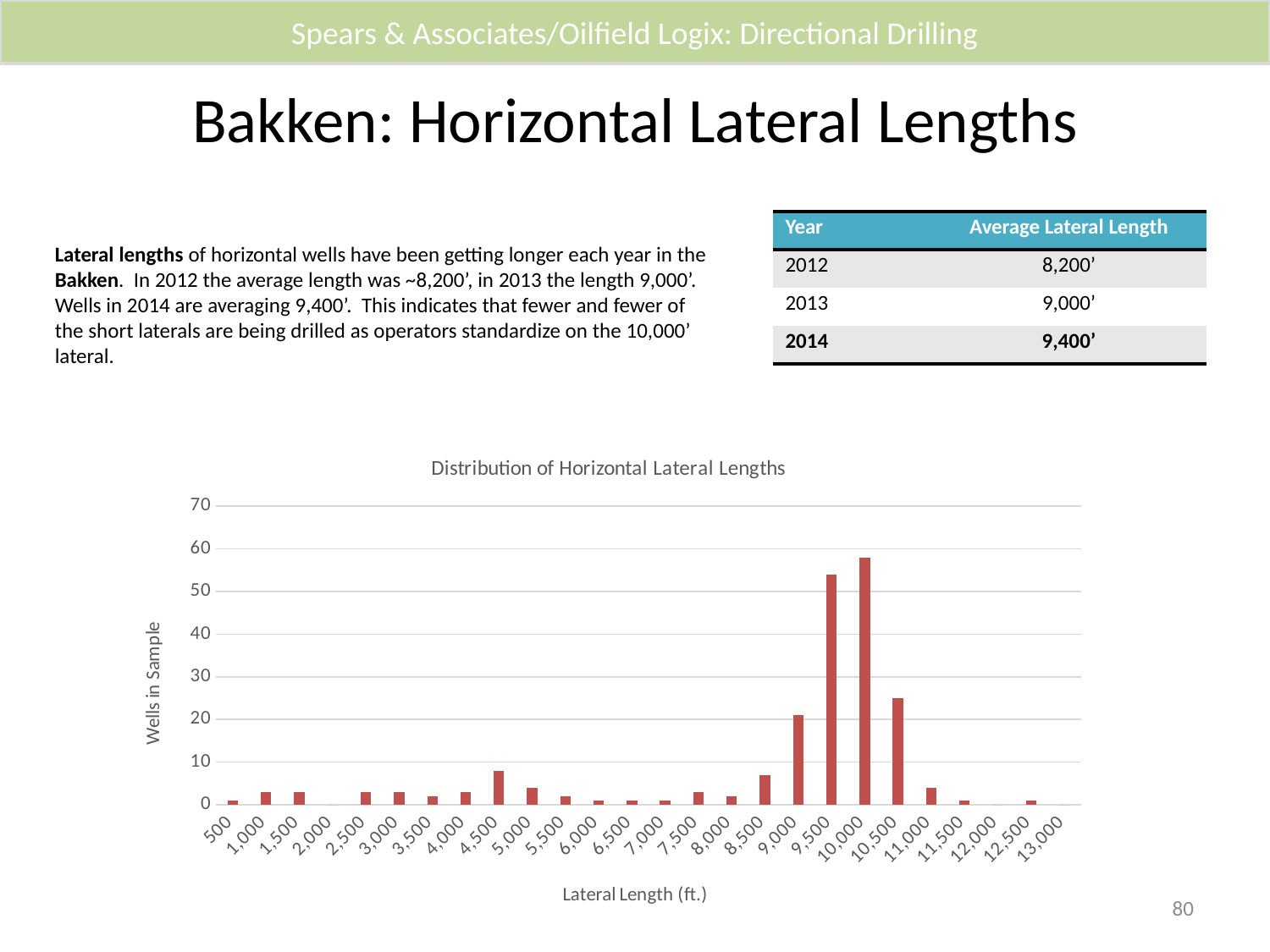
What kind of chart is shown on the slide? bar chart Which lateral length category has the highest number of wells in sample? 10,000 What is the title of the chart? Distribution of Horizontal Lateral Lengths Is the value for 4,500 greater or less than 10? less Which has more wells in sample, 9,000 or 9,500? 9,500 Is the value for 10,500 greater or less than 20? greater Is the value for 10,000 greater or less than 50? greater How many lateral length categories are shown on the x axis of the chart? 26 What is the label of the vertical axis of the chart? Wells in Sample Which has more wells in sample, 10,000 or 10,500? 10,000